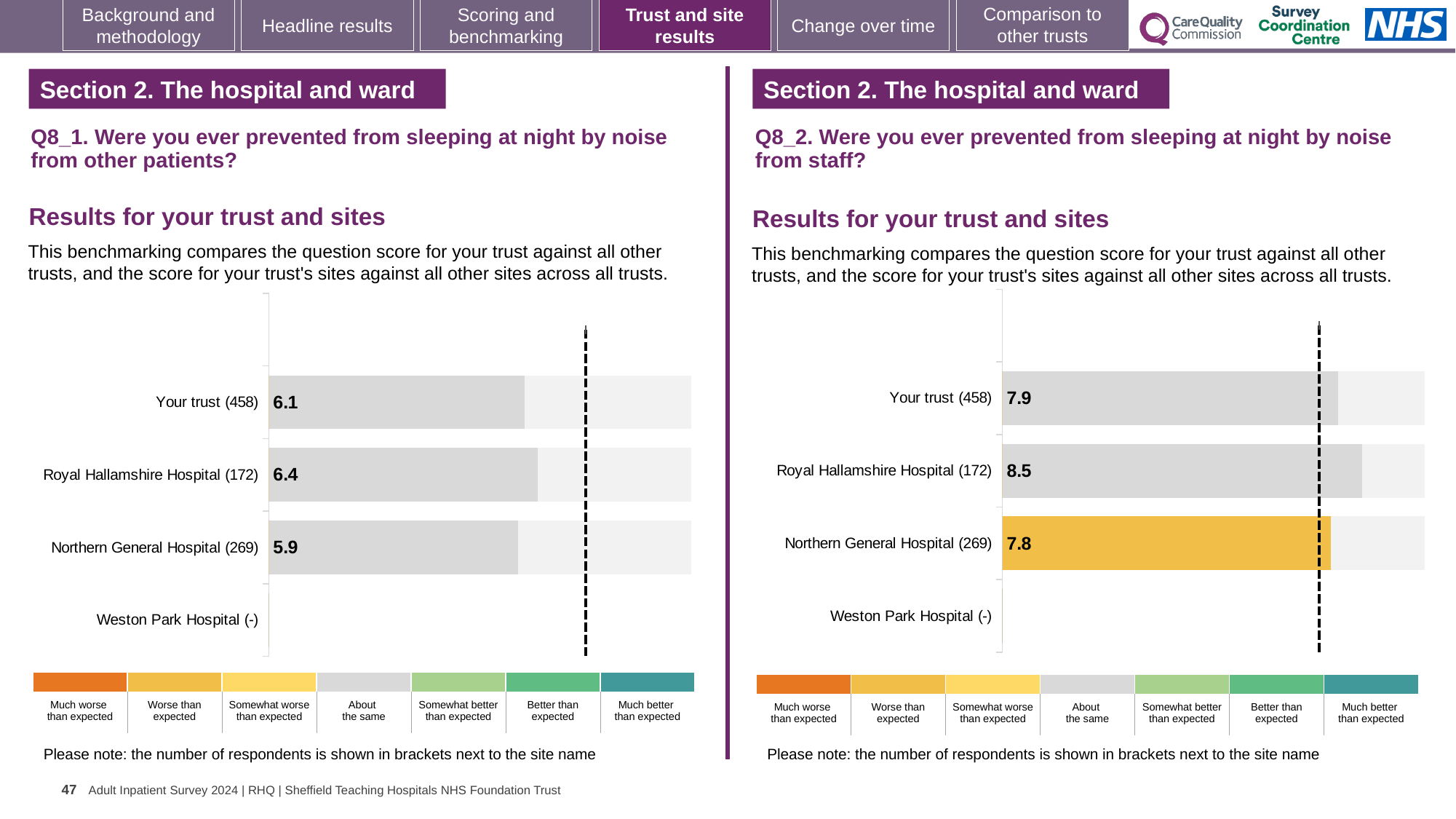
On the Q8_2 chart (right), which site has the lowest score among those with a value shown? Northern General Hospital On the Q8_2 chart (right), what is the score for Royal Hallamshire Hospital? 8.5 On the Q8_1 chart (left), what is the score for Northern General Hospital? 5.9 What kind of chart is used on the Q8_1 chart (left)? Bar chart On the Q8_2 chart (right), what is the score for Northern General Hospital? 7.8 On the Q8_1 chart (left), what is the difference between the scores for Royal Hallamshire Hospital and Northern General Hospital? 0.5 On the Q8_2 chart (right), how many respondents are shown in brackets for Your trust? 458 On the Q8_1 chart (left), which site has the highest score? Royal Hallamshire Hospital On the Q8_2 chart (right), is the score for Royal Hallamshire Hospital larger or smaller than the score for Your trust? larger On the Q8_2 chart (right), what is the score for Your trust? 7.9 On the Q8_1 chart (left), what is the score for Your trust? 6.1 On the Q8_1 chart (left), what is the score for Royal Hallamshire Hospital? 6.4